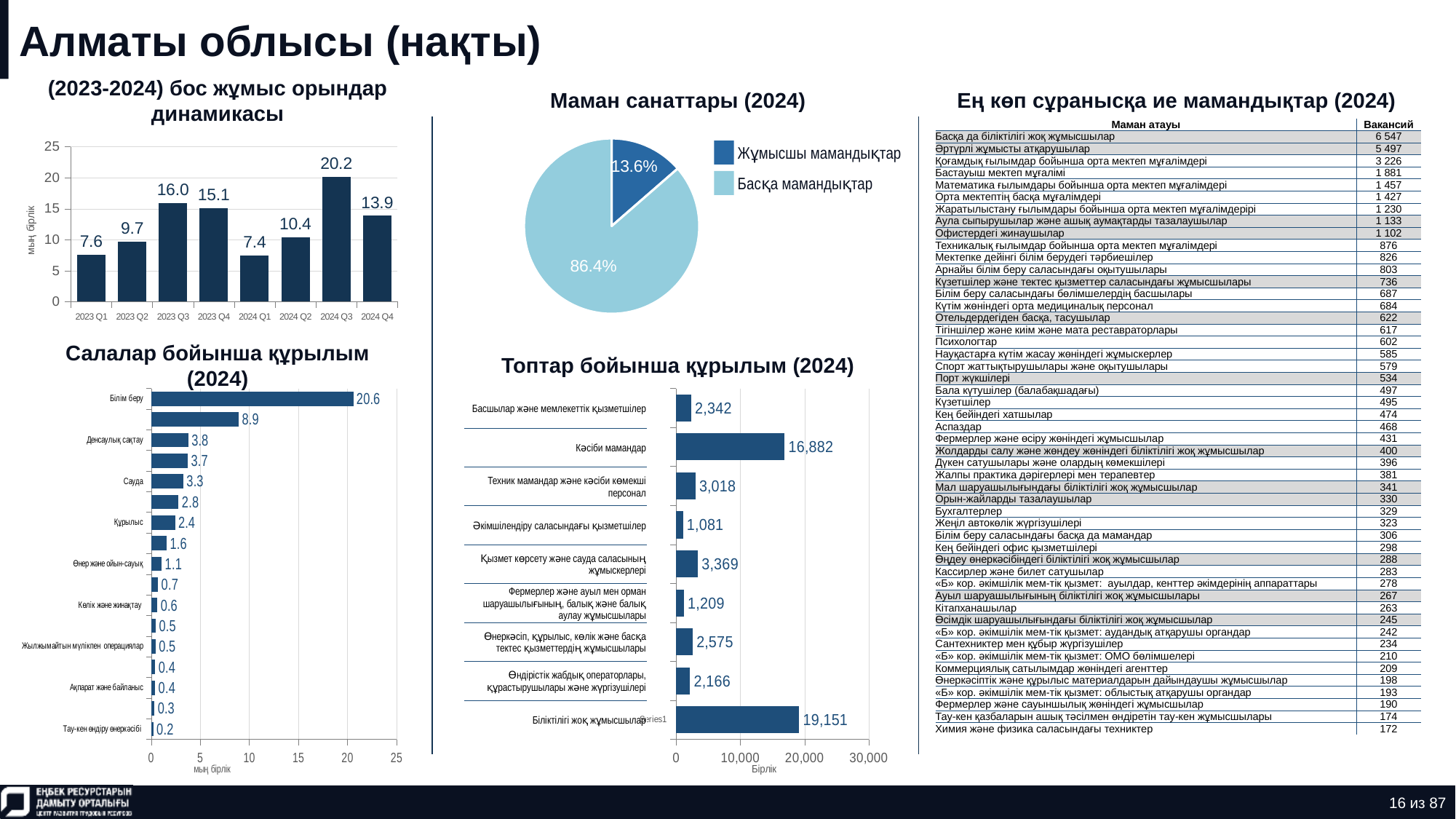
In the chart 'Салалар бойынша құрылым (2024)', which is larger: 'Денсаулық сақтау' or 'Сауда'? Денсаулық сақтау In the chart '(2023-2024) бос жұмыс орындар динамикасы', which quarter has the lowest value? 2024 Q1 What kind of chart is 'Маман санаттары (2024)'? pie chart In the chart 'Топтар бойынша құрылым (2024)', which category has the highest value? Біліктілігі жоқ жұмысшылар In the pie chart 'Маман санаттары (2024)', what share is 'Жұмысшы мамандықтар'? 13.6% In the chart 'Салалар бойынша құрылым (2024)', what is the value for 'Білім беру'? 20.6 In the chart '(2023-2024) бос жұмыс орындар динамикасы', what is the value for 2024 Q3? 20.2 In the chart 'Топтар бойынша құрылым (2024)', what is the difference between 'Қызмет көрсету және сауда саласының жұмыскерлері' and 'Әкімшілендіру саласындағы қызметшілер'? 2,288 In the chart '(2023-2024) бос жұмыс орындар динамикасы', how many quarters are plotted? 8 In the chart '(2023-2024) бос жұмыс орындар динамикасы', what is the difference between 2023 Q3 and 2023 Q1? 8.4 In the chart 'Салалар бойынша құрылым (2024)', which category has the lowest value? Тау-кен өндіру өнеркәсібі In the chart 'Топтар бойынша құрылым (2024)', what is the value for 'Кәсіби мамандар'? 16,882